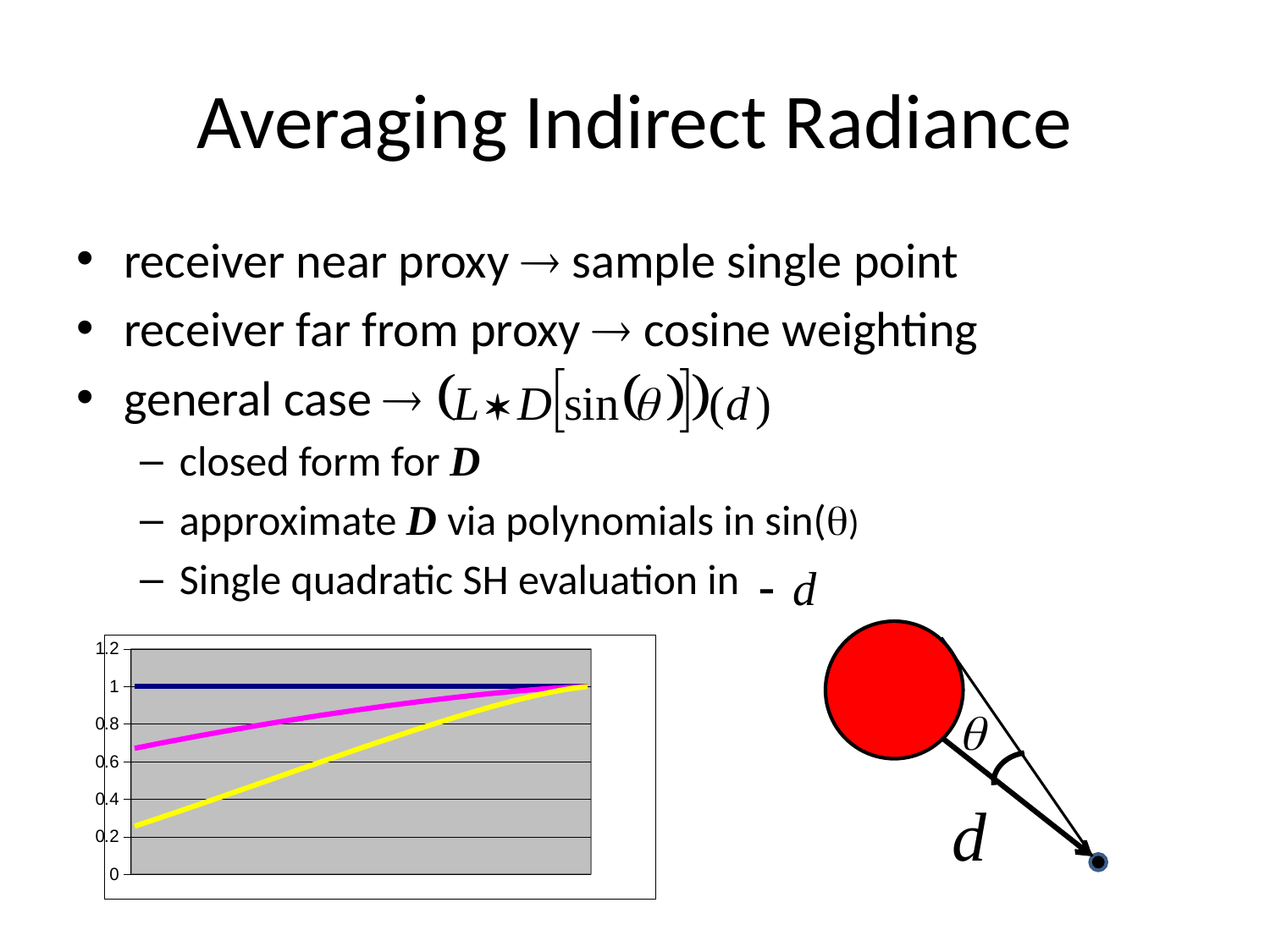
In the chart at the bottom left, is the value of the dark blue line greater or less than 0.8? greater What kind of chart is shown at the bottom left of the slide? line chart In the chart at the bottom left, which line has the lowest value at the left edge of the chart? the yellow line In the chart at the bottom left, does the magenta line rise or fall from left to right? rise What is the highest tick value shown on the y axis of the chart at the bottom left? 1.2 How many lines are plotted in the chart at the bottom left of the slide? 3 In the chart at the bottom left, is the starting value of the yellow line at the left edge greater or less than 0.4? less In the chart at the bottom left, does the yellow line rise or fall from left to right? rise In the chart at the bottom left, which line has the highest value at the left edge of the chart? the dark blue line In the chart at the bottom left, at the left edge, is the magenta line or the yellow line higher? the magenta line In the chart at the bottom left, does the dark blue line rise, fall, or stay flat from left to right? stay flat In the chart at the bottom left, is the starting value of the magenta line at the left edge greater or less than 0.8? less